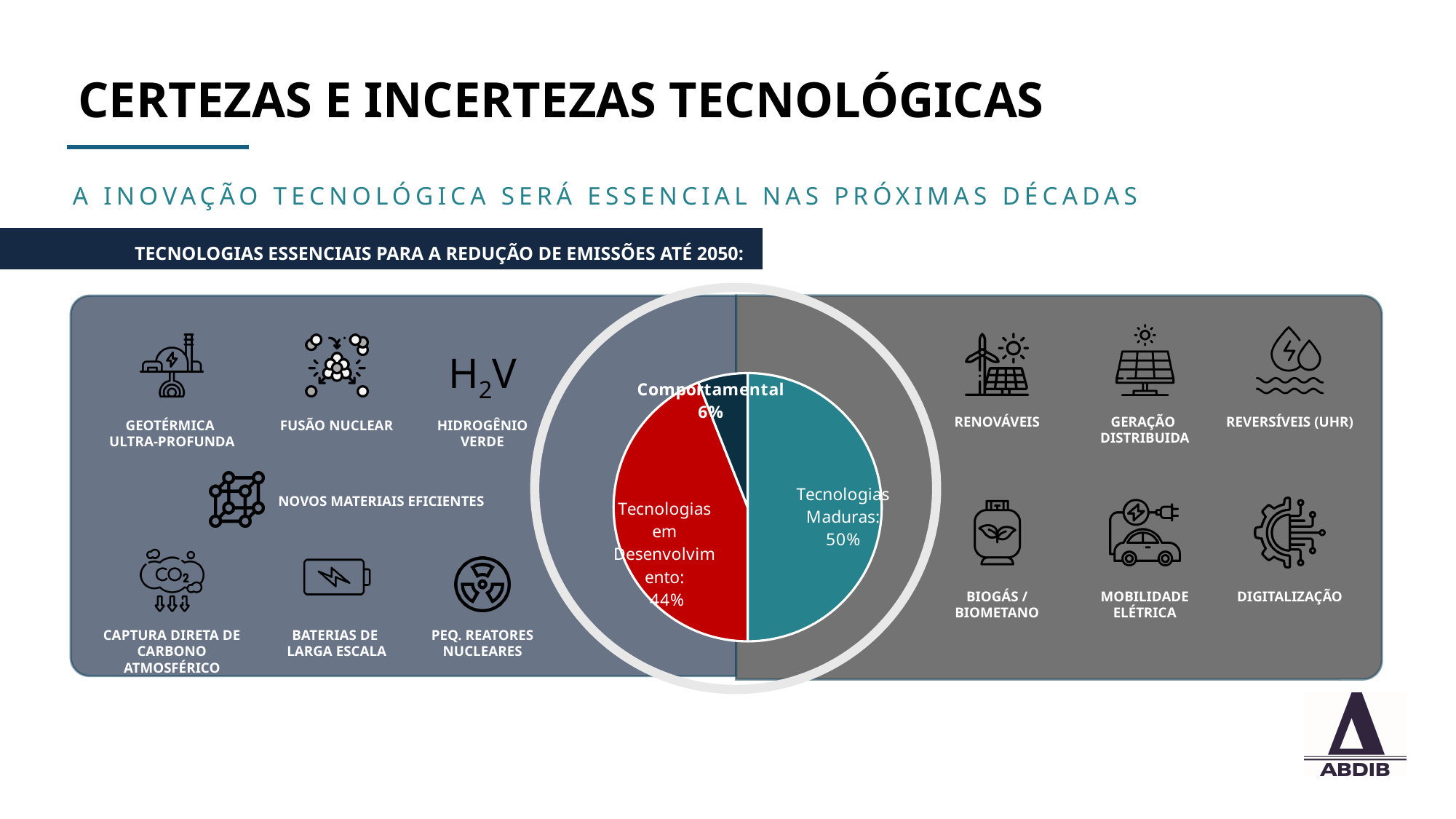
What is the difference between the Tecnologias Maduras share and the Tecnologias em Desenvolvimento share? 6% Which slice of the pie is the smallest? Comportamental What is the difference between the Tecnologias em Desenvolvimento share and the Comportamental share? 38% What kind of chart is shown on the slide? pie chart Which slice of the pie is the largest? Tecnologias Maduras What colour is the Tecnologias em Desenvolvimento slice of the pie? red What colour is the Tecnologias Maduras slice of the pie? teal What share of the pie is labelled Tecnologias Maduras? 50% What share of the pie is labelled Comportamental? 6% Which is larger, the Tecnologias em Desenvolvimento slice or the Comportamental slice? Tecnologias em Desenvolvimento What share of the pie is labelled Tecnologias em Desenvolvimento? 44% How many slices does the pie chart have? 3